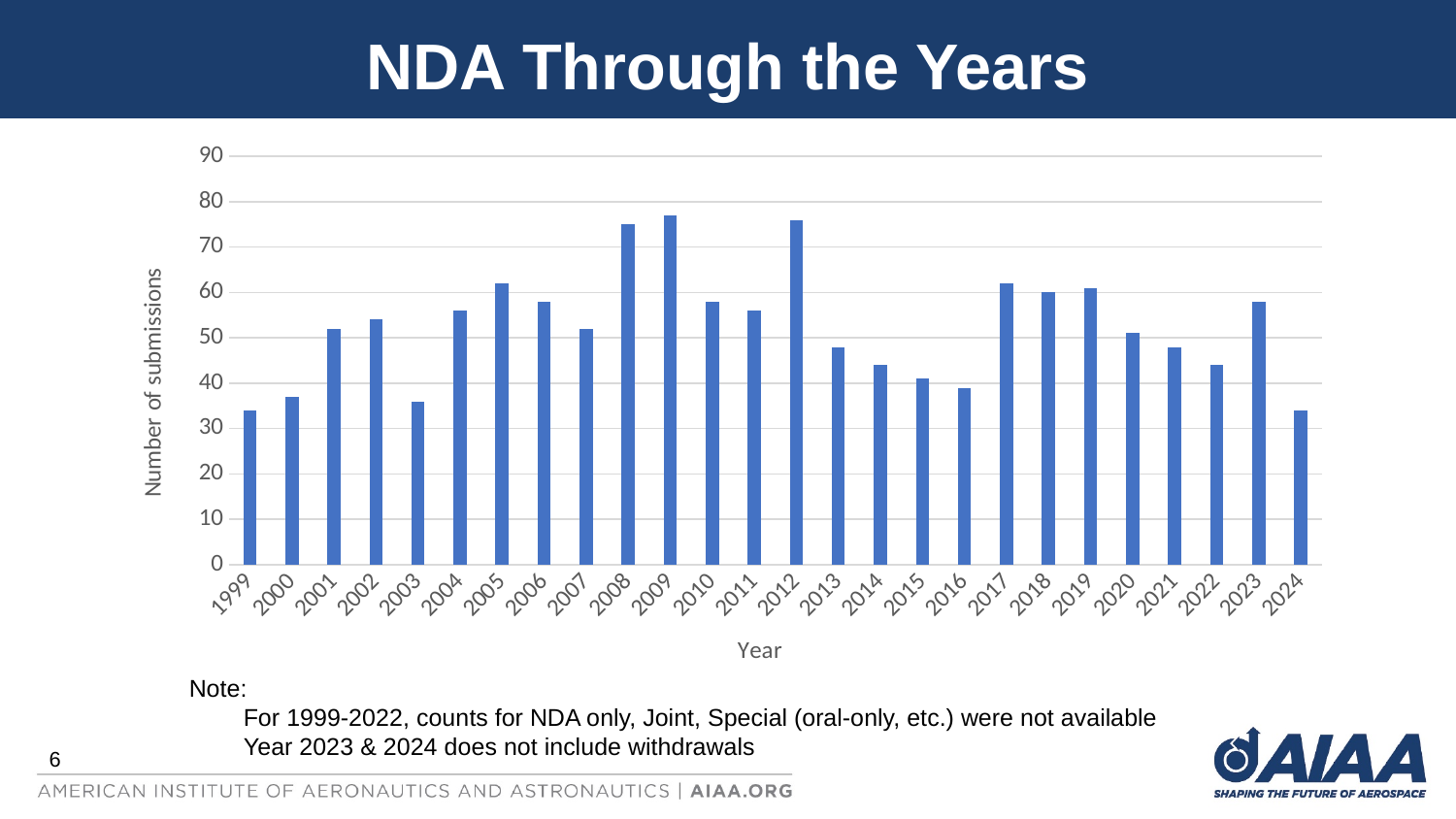
What kind of chart is shown on the slide? bar chart Is the value for 2009 greater or less than 70? greater Is the value for 2003 greater or less than 40? less How many years are plotted on the x axis of the chart? 26 Is the value for 2016 greater or less than 50? less What is the label of the horizontal axis? Year Do the values rise or fall from 2019 to 2022? fall Which year has the larger value, 2017 or 2015? 2017 What is the label of the vertical axis? Number of submissions Which year has the larger value, 2008 or 2003? 2008